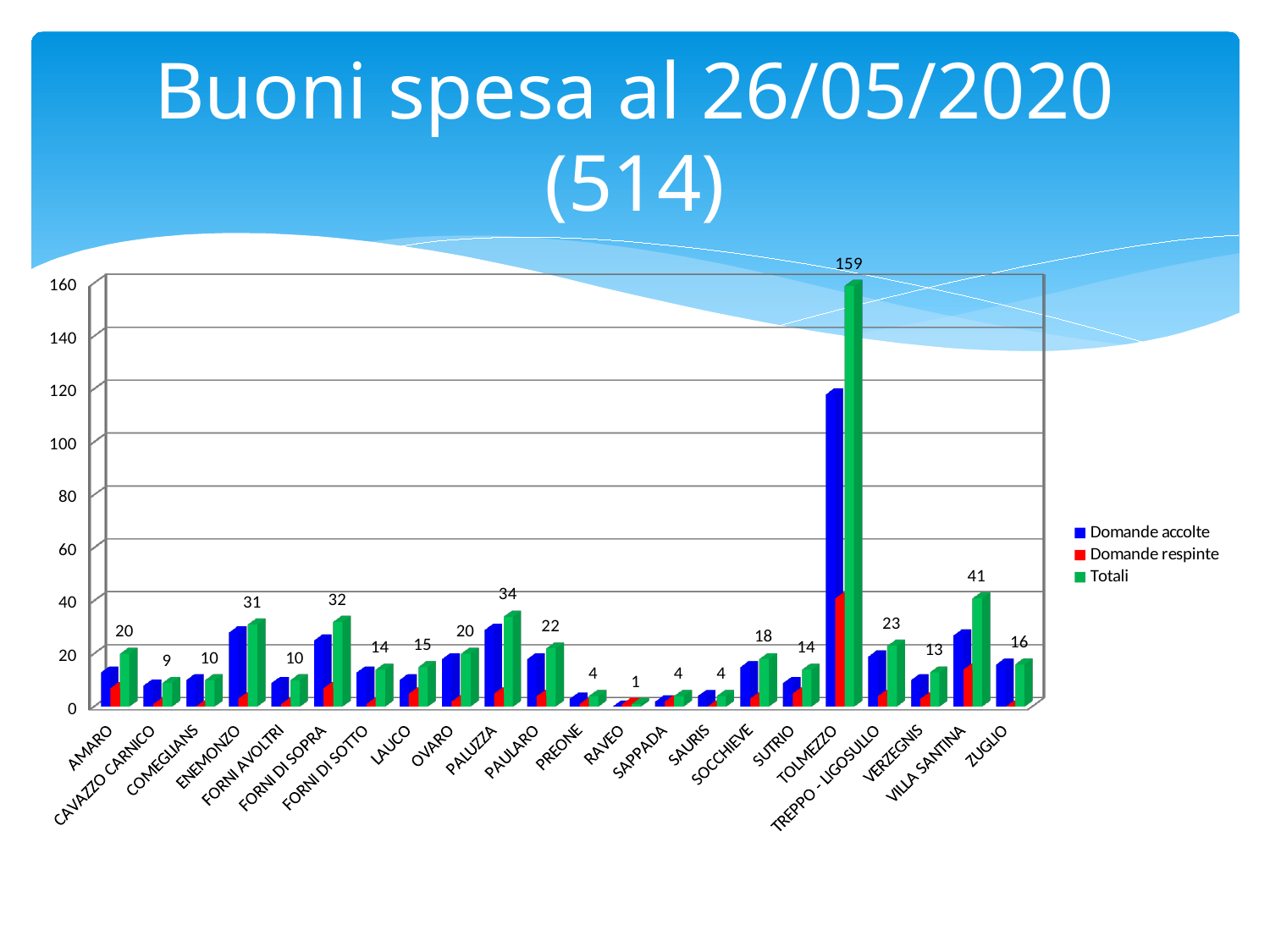
Which category has the highest Totali value? TOLMEZZO Is the Domande accolte value for TOLMEZZO greater or less than 100? greater How many categories are shown on the x axis? 22 How many series does the legend list? 3 Which category has the lowest Totali value? RAVEO What is the Totali value for VILLA SANTINA? 41 What kind of chart is shown on the slide? Bar chart What is the Totali value for PALUZZA? 34 What is the title of the slide? Buoni spesa al 26/05/2020 (514) Which has a larger Totali value, VILLA SANTINA or PAULARO? VILLA SANTINA What is the Totali value for TOLMEZZO? 159 What is the difference between the Totali values for FORNI DI SOPRA and ENEMONZO? 1